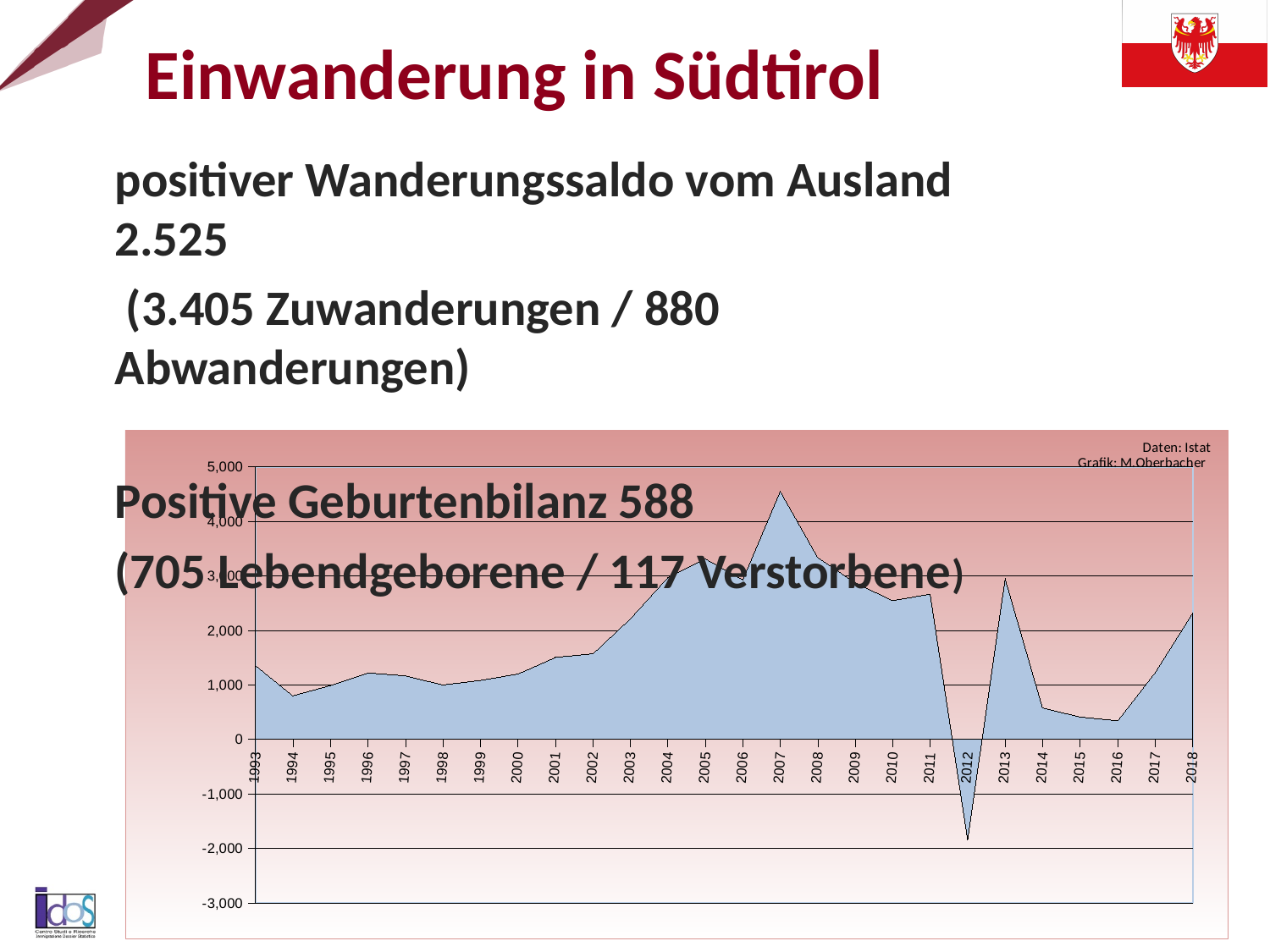
How many years are plotted along the x axis of the chart? 26 Is the value for 2018 greater or less than 2,000? greater Which year has the highest value in the chart? 2007 According to the note in the top right of the chart, what is the data source? Istat Which year has the larger value, 2007 or 2013? 2007 Which year has the larger value, 1998 or 2003? 2003 Do the values rise or fall from 2013 to 2016? fall Which year has the lowest value in the chart? 2012 Is the value for 2007 greater or less than 4,000? greater Is the value for 2016 greater or less than 1,000? less What kind of chart is shown on the slide? area chart